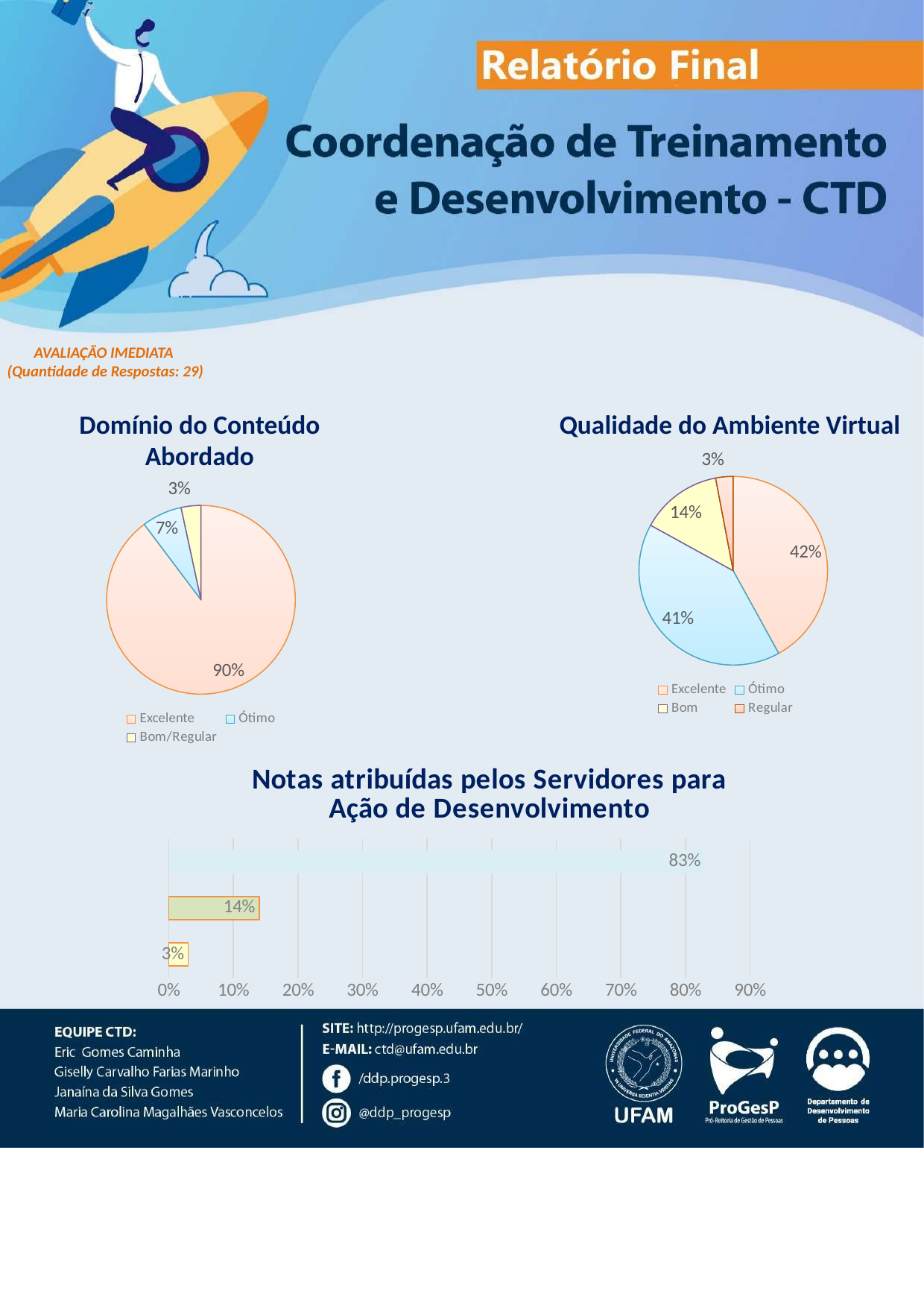
In the 'Notas atribuídas pelos Servidores para Ação de Desenvolvimento' chart, what is the value of the longest bar? 83% What kind of chart is 'Qualidade do Ambiente Virtual'? Pie chart In the 'Qualidade do Ambiente Virtual' chart, what percentage is shown for Bom? 14% In the 'Domínio do Conteúdo Abordado' chart, what share of responses is Excelente? 90% What kind of chart is 'Notas atribuídas pelos Servidores para Ação de Desenvolvimento'? Bar chart How many categories does the legend of the 'Qualidade do Ambiente Virtual' chart list? 4 In the 'Domínio do Conteúdo Abordado' chart, which category has the smallest slice? Bom/Regular In the 'Domínio do Conteúdo Abordado' chart, what percentage is shown for Ótimo? 7% How many categories does the legend of the 'Domínio do Conteúdo Abordado' chart list? 3 In the 'Qualidade do Ambiente Virtual' chart, what is the difference between the Bom and Regular percentages? 11% In the 'Qualidade do Ambiente Virtual' chart, which category has the largest slice? Excelente How many bars are plotted in the 'Notas atribuídas pelos Servidores para Ação de Desenvolvimento' chart? 3